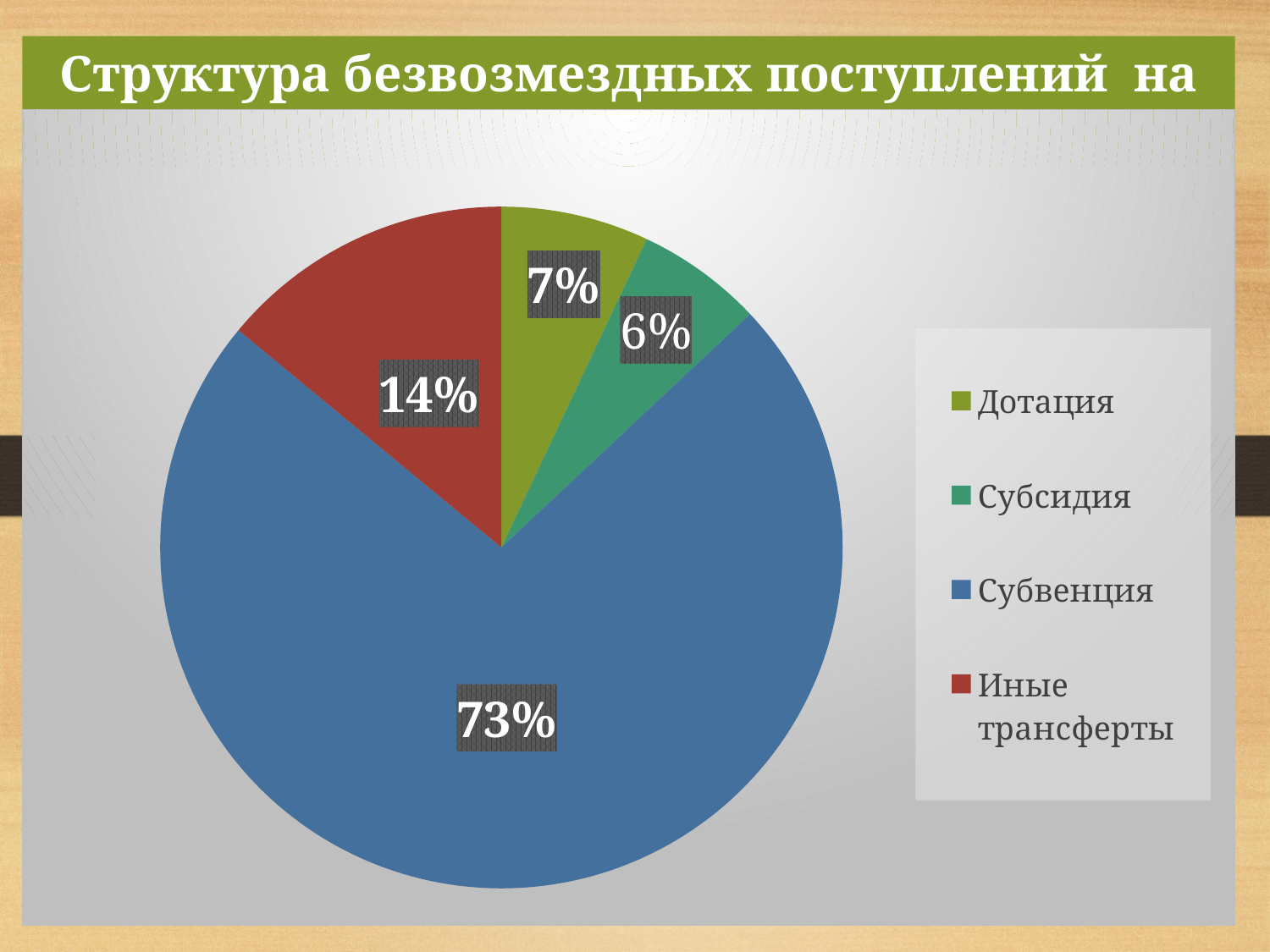
Which category has the smallest share of the pie? Субсидия What is the combined share of Дотация and Субсидия? 13% Which is larger, the share of Дотация or the share of Субсидия? Дотация What share of the pie does Субвенция have? 73% What share of the pie does Дотация have? 7% Which category has the largest share of the pie? Субвенция What is the difference between the shares of Субвенция and Иные трансферты? 59% What share of the pie does Иные трансферты have? 14% How many categories does the legend list? 4 What kind of chart is shown on the slide? pie chart What colour is the slice for Иные трансферты? red